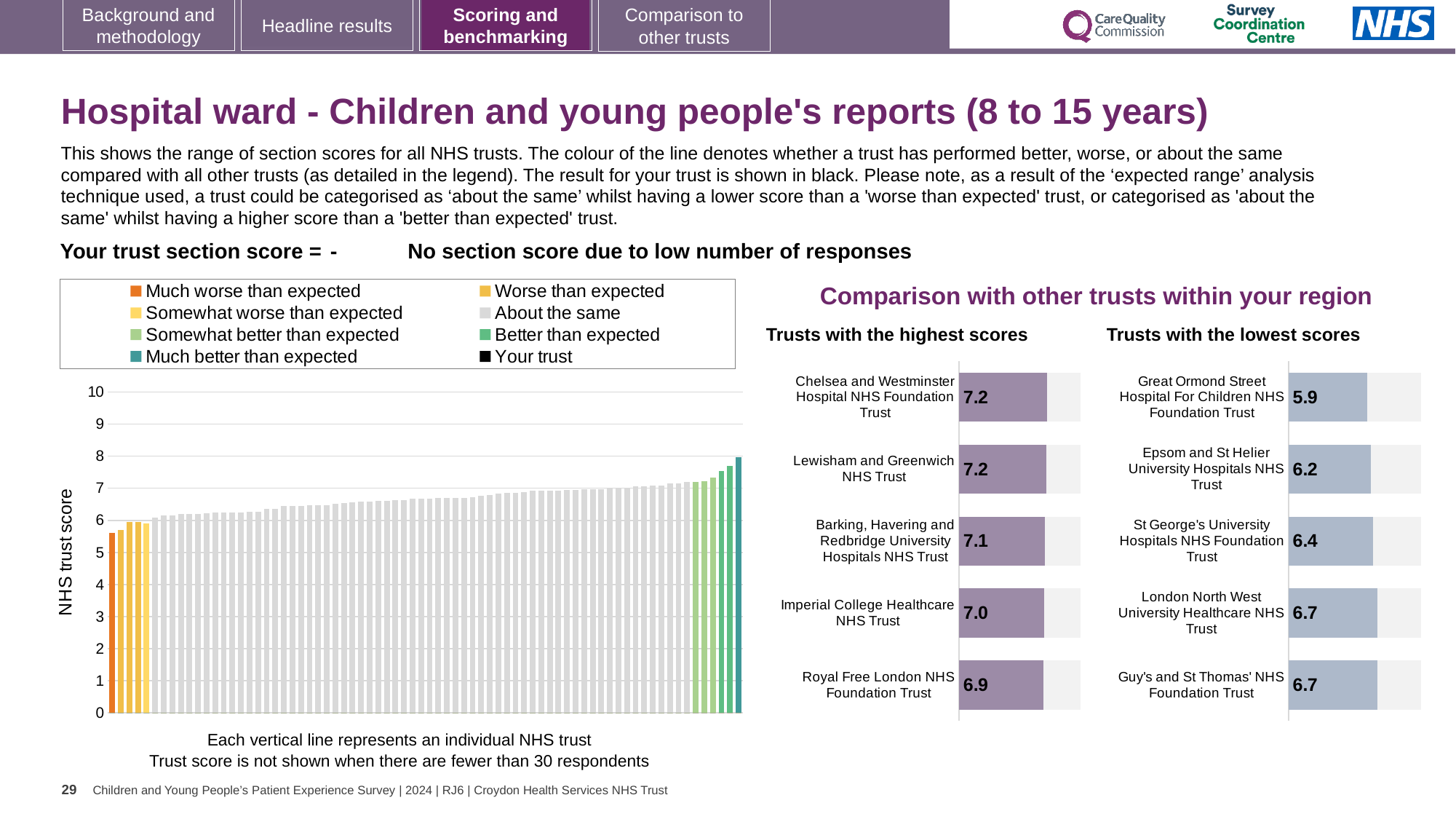
In the NHS trust score chart on the left, do the bar values rise or fall from left to right? Rise What kind of chart is the NHS trust score chart on the left? Bar chart In the 'Trusts with the lowest scores' chart, which trust has the lowest score? Great Ormond Street Hospital For Children NHS Foundation Trust In the 'Trusts with the highest scores' chart, what is the score for Imperial College Healthcare NHS Trust? 7.0 How many trusts are shown in the 'Trusts with the highest scores' chart? 5 In the 'Trusts with the highest scores' chart, which has the higher score: Barking, Havering and Redbridge University Hospitals NHS Trust or Imperial College Healthcare NHS Trust? Barking, Havering and Redbridge University Hospitals NHS Trust In the 'Trusts with the highest scores' chart, what is the difference between the scores of Chelsea and Westminster Hospital NHS Foundation Trust and Royal Free London NHS Foundation Trust? 0.3 In the NHS trust score chart on the left, is the value of the leftmost (lowest) bar greater or less than 6? less In the 'Trusts with the highest scores' chart, which trust has the lowest score? Royal Free London NHS Foundation Trust In the 'Trusts with the lowest scores' chart, what is the difference between the scores of Guy's and St Thomas' NHS Foundation Trust and Great Ormond Street Hospital For Children NHS Foundation Trust? 0.8 How many entries does the legend of the NHS trust score chart on the left list? 8 In the 'Trusts with the lowest scores' chart, what is the score for Great Ormond Street Hospital For Children NHS Foundation Trust? 5.9